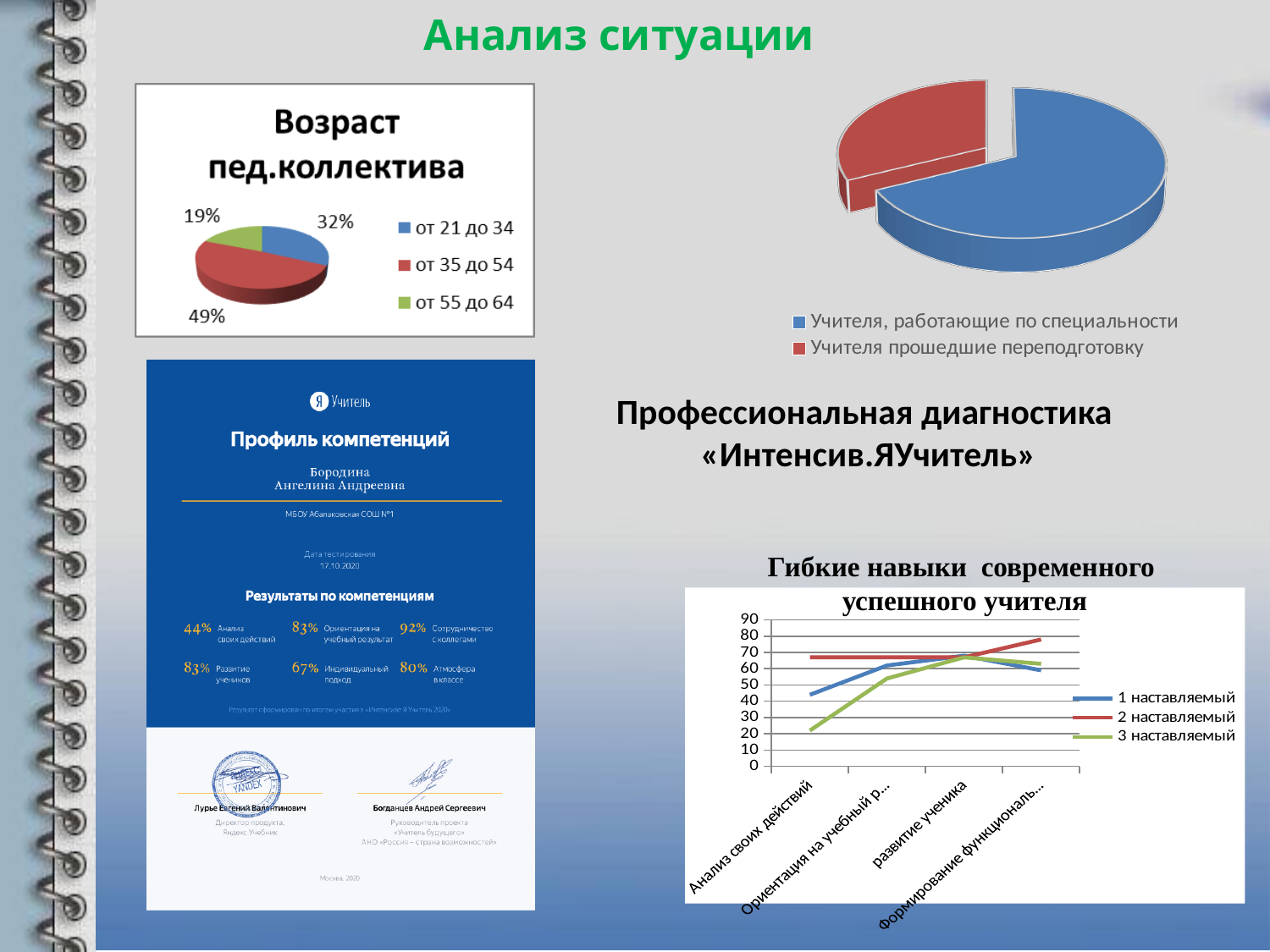
In the pie chart at the top right of the slide, how many categories does the legend list? 2 In the chart titled "Гибкие навыки современного успешного учителя", is the value for "3 наставляемый" at "Анализ своих действий" greater or less than 30? less In the chart titled "Возраст пед.коллектива", how many age groups are shown? 3 In the chart titled "Возраст пед.коллектива", what share is shown for "от 21 до 34"? 32% In the chart titled "Возраст пед.коллектива", what share is shown for "от 35 до 54"? 49% In the chart titled "Возраст пед.коллектива", which age group has the largest share? от 35 до 54 In the chart titled "Гибкие навыки современного успешного учителя", which series has the highest value at the last category ("Формирование функциональ...")? 2 наставляемый In the chart titled "Возраст пед.коллектива", which age group has the smallest share? от 55 до 64 In the chart titled "Гибкие навыки современного успешного учителя", how many series does the legend list? 3 In the chart titled "Возраст пед.коллектива", what is the difference between the shares for "от 35 до 54" and "от 55 до 64"? 30 percentage points In the pie chart at the top right of the slide, which category has the larger slice? Учителя, работающие по специальности What kind of chart is the chart titled "Гибкие навыки современного успешного учителя"? Line chart